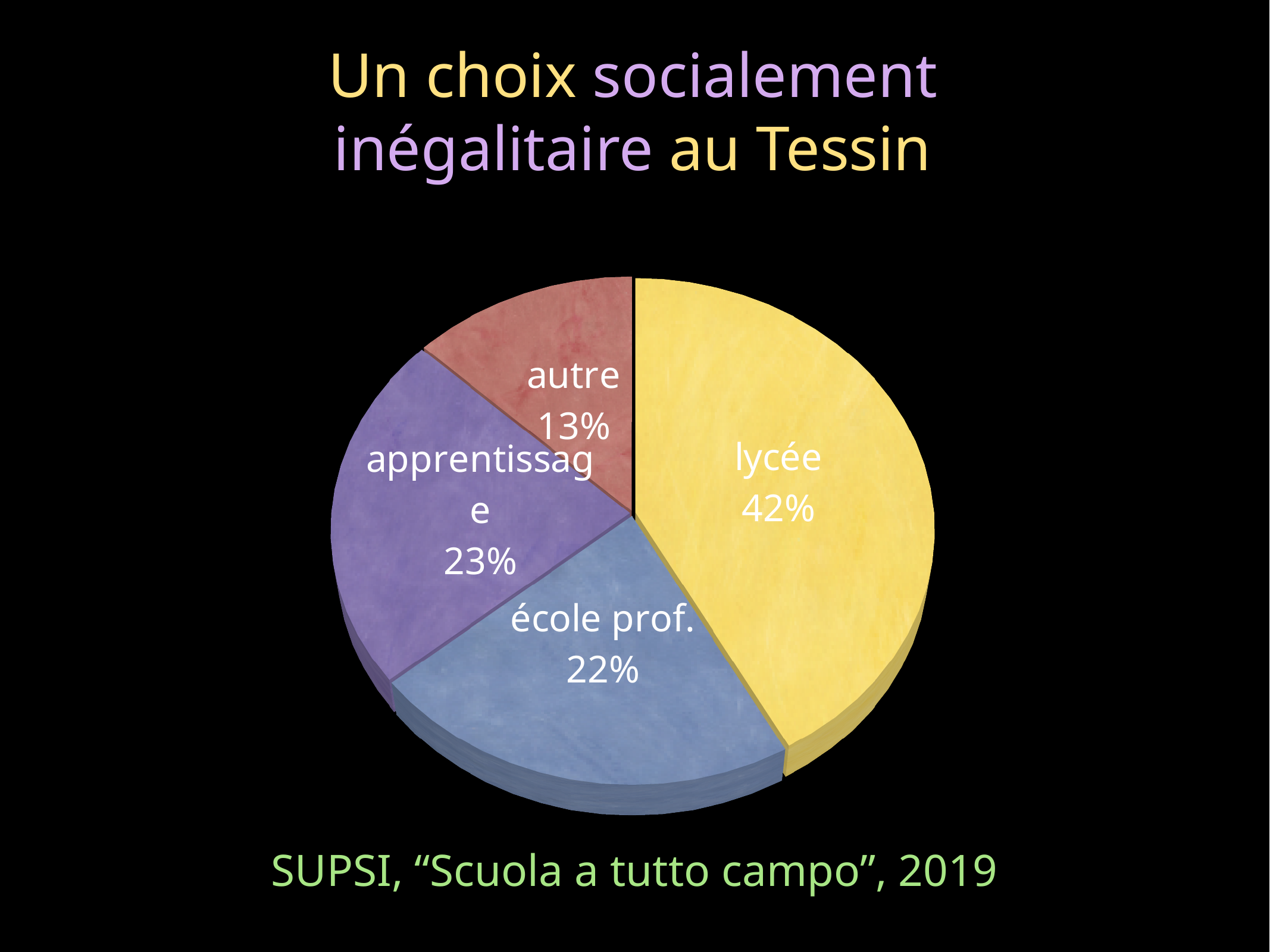
Which category has the smallest share of the pie? autre What is the difference in percentage points between apprentissage and école prof.? 1 How many slices does the pie chart have? 4 Which is larger, the share for lycée or the share for école prof.? lycée Which category has the largest share of the pie? lycée What kind of chart is shown on the slide? pie chart What colour is the lycée slice? yellow What percentage is shown for apprentissage? 23% What percentage is shown for autre? 13% What is the difference in percentage points between lycée and autre? 29 What percentage is shown for lycée? 42% What percentage is shown for école prof.? 22%